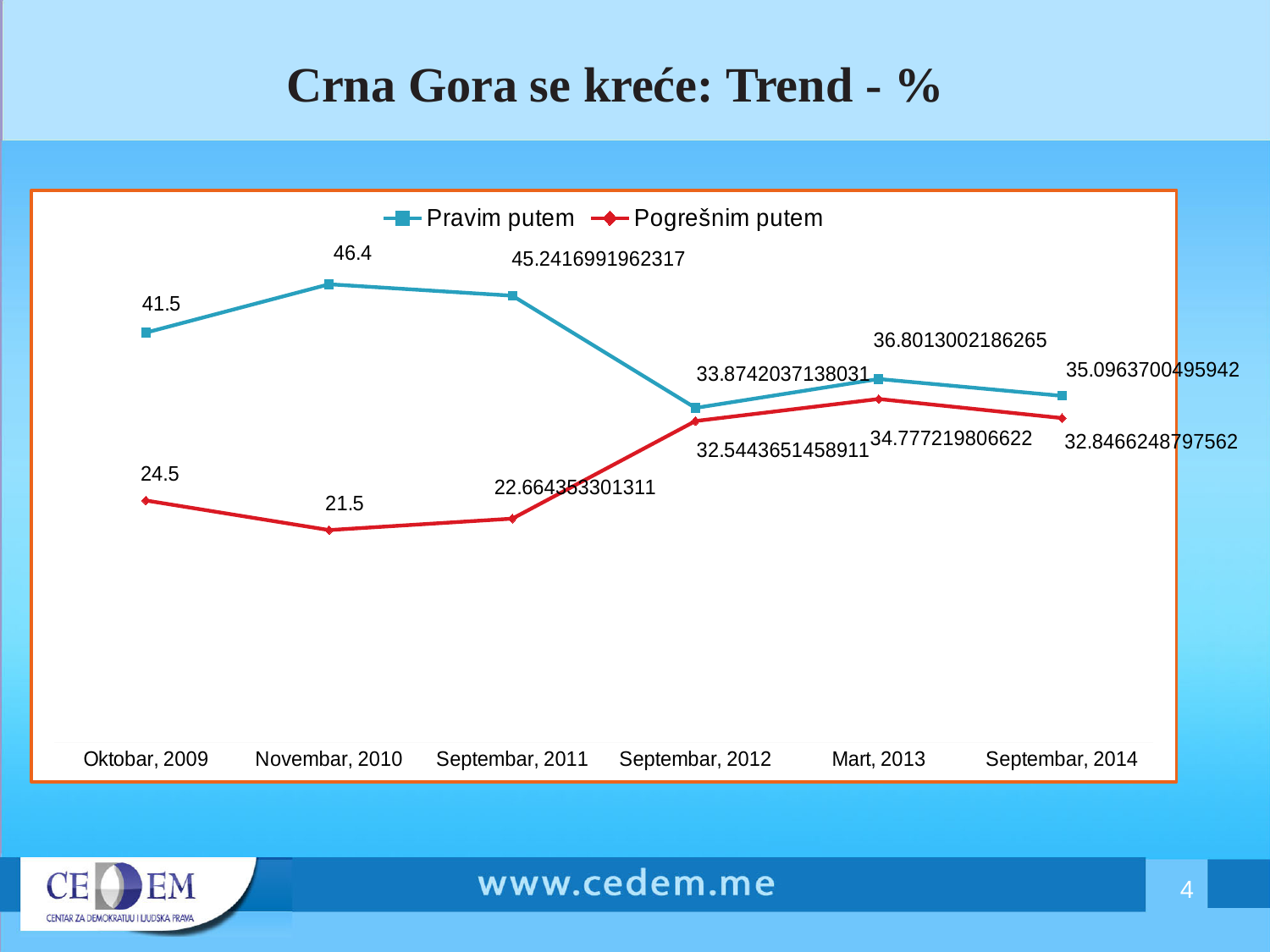
What is the value for Pogrešnim putem in Septembar, 2014? 32.8466248797562 At which time point is Pogrešnim putem lowest? Novembar, 2010 In Oktobar, 2009, which series has the larger value, Pravim putem or Pogrešnim putem? Pravim putem What is the value for Pravim putem in Novembar, 2010? 46.4 What is the difference between the Pravim putem values in Novembar, 2010 and Oktobar, 2009? 4.9 At which time point is Pravim putem highest? Novembar, 2010 What is the value for Pravim putem in Mart, 2013? 36.8013002186265 Does the Pogrešnim putem series overall rise or fall from Oktobar, 2009 to Septembar, 2014? Rise What type of chart is shown on the slide? Line chart How many time points are plotted along the x axis? 6 What is the value for Pogrešnim putem in Oktobar, 2009? 24.5 How many series does the legend list? 2